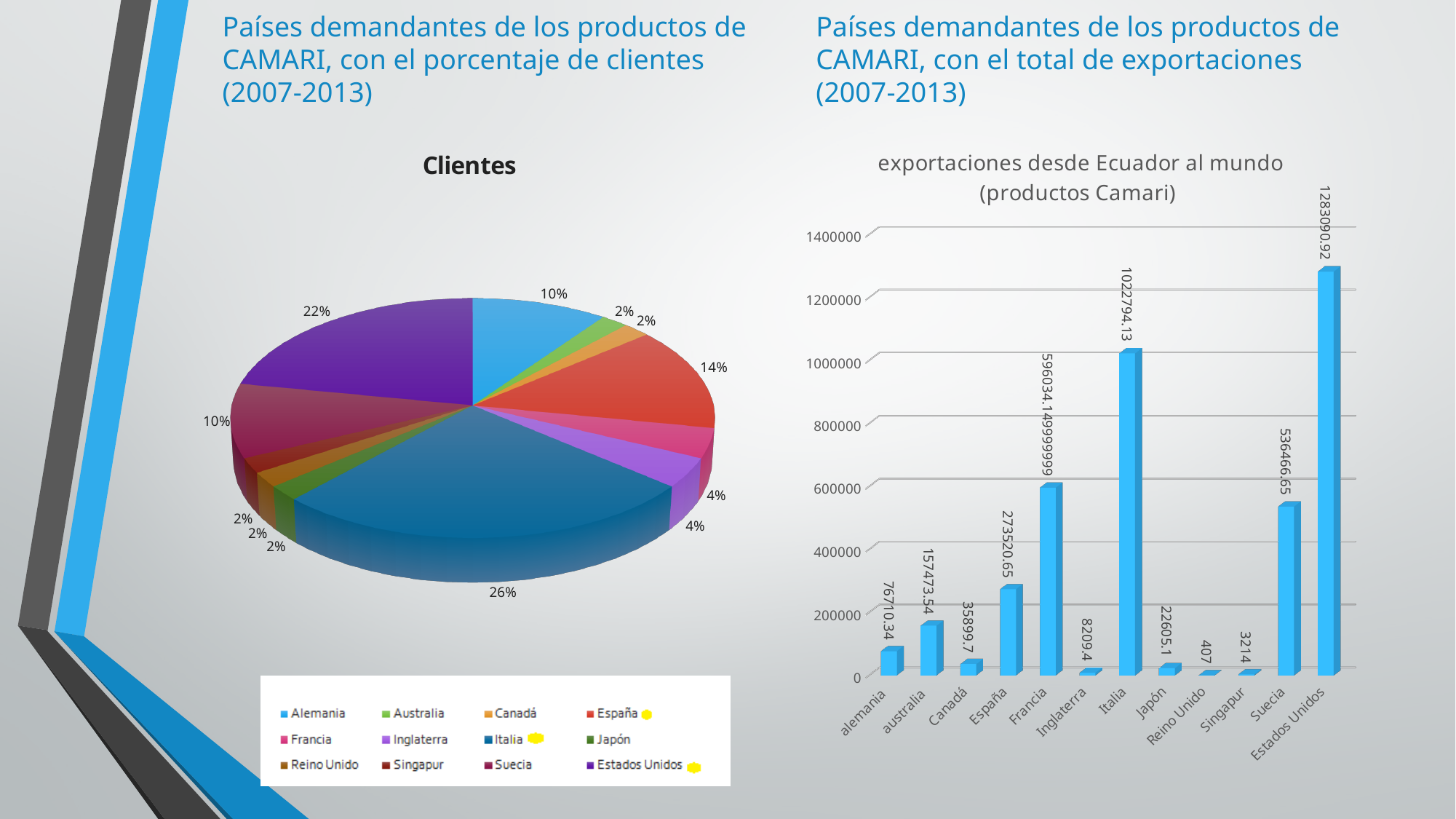
In the 'exportaciones desde Ecuador al mundo (productos Camari)' bar chart, what is the difference between the values for Singapur and Reino Unido? 2807 In the 'Clientes' pie chart, what share of clients does Estados Unidos represent? 22% How many entries does the legend of the 'Clientes' pie chart list? 12 In the 'exportaciones desde Ecuador al mundo (productos Camari)' bar chart, which country has the highest value? Estados Unidos In the 'exportaciones desde Ecuador al mundo (productos Camari)' bar chart, what is the value for Italia? 1022794.13 In the 'Clientes' pie chart, what share of clients does Italia represent? 26% In the 'exportaciones desde Ecuador al mundo (productos Camari)' bar chart, which country has the lowest value? Reino Unido What type of chart is the 'exportaciones desde Ecuador al mundo (productos Camari)' chart? bar chart In the 'exportaciones desde Ecuador al mundo (productos Camari)' bar chart, what is the value for Suecia? 536466.65 In the 'Clientes' pie chart, which country has the largest share? Italia In the 'exportaciones desde Ecuador al mundo (productos Camari)' bar chart, which is larger: the value for España or the value for australia? España How many countries are shown in the 'exportaciones desde Ecuador al mundo (productos Camari)' bar chart? 12